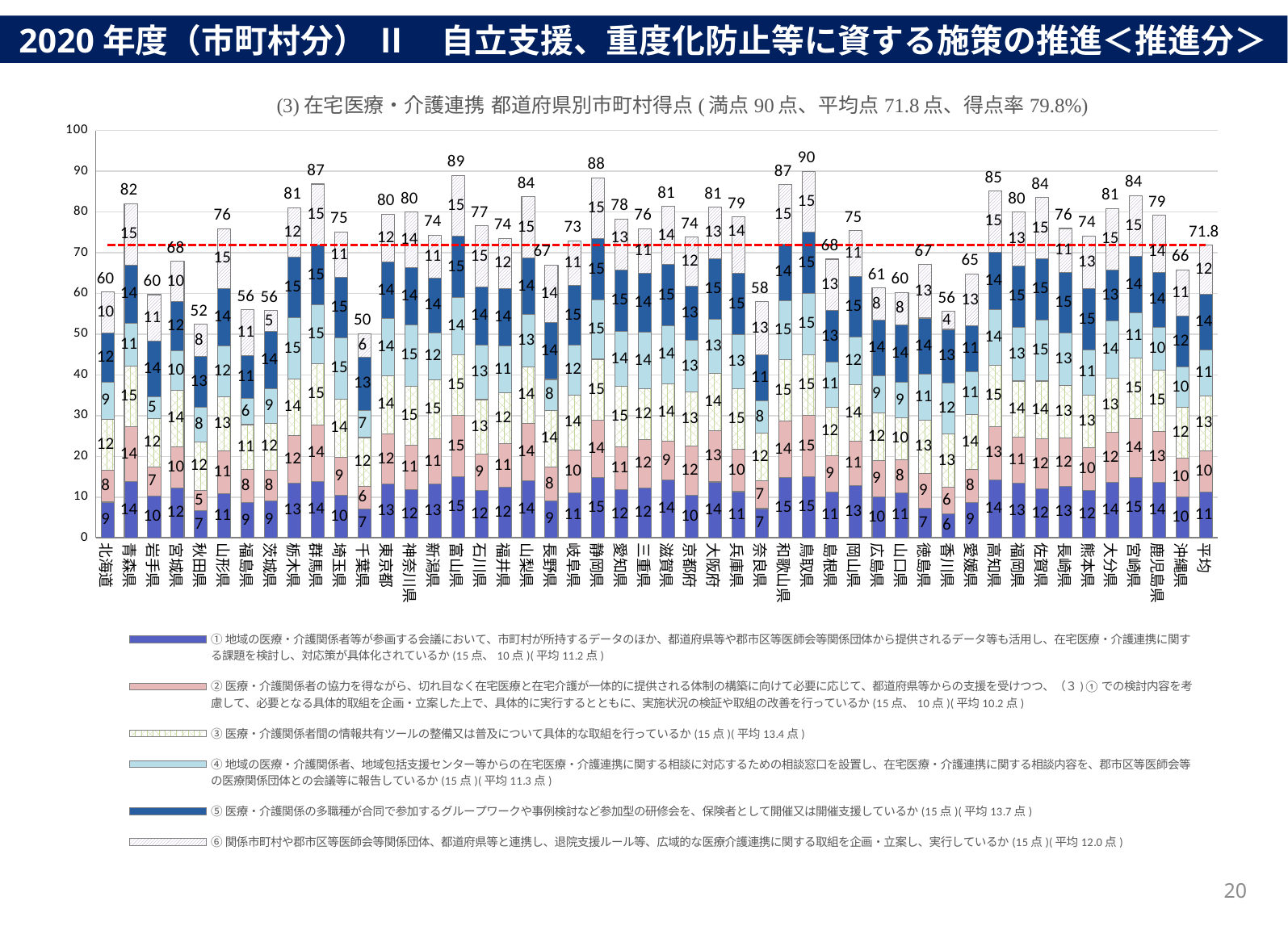
Which has a higher total score, 青森県 or 岩手県? 青森県 Is the total score for 秋田県 greater or less than 60? less What kind of chart is shown on the slide? Stacked bar chart What is the total score for 富山県? 89 What is the total score for 静岡県? 88 What is the difference between the total score of 高知県 and that of 福岡県? 5 Which prefecture has the lowest total score in the chart? 千葉県 What is the value of the bottom (series ①) segment for 北海道? 9 Which prefecture has the highest total score in the chart? 鳥取県 How many series does the legend list? 6 What is the value shown for 平均 (the average bar) at the right end of the chart? 71.8 What is the difference between the total score of 鳥取県 and that of 千葉県? 40